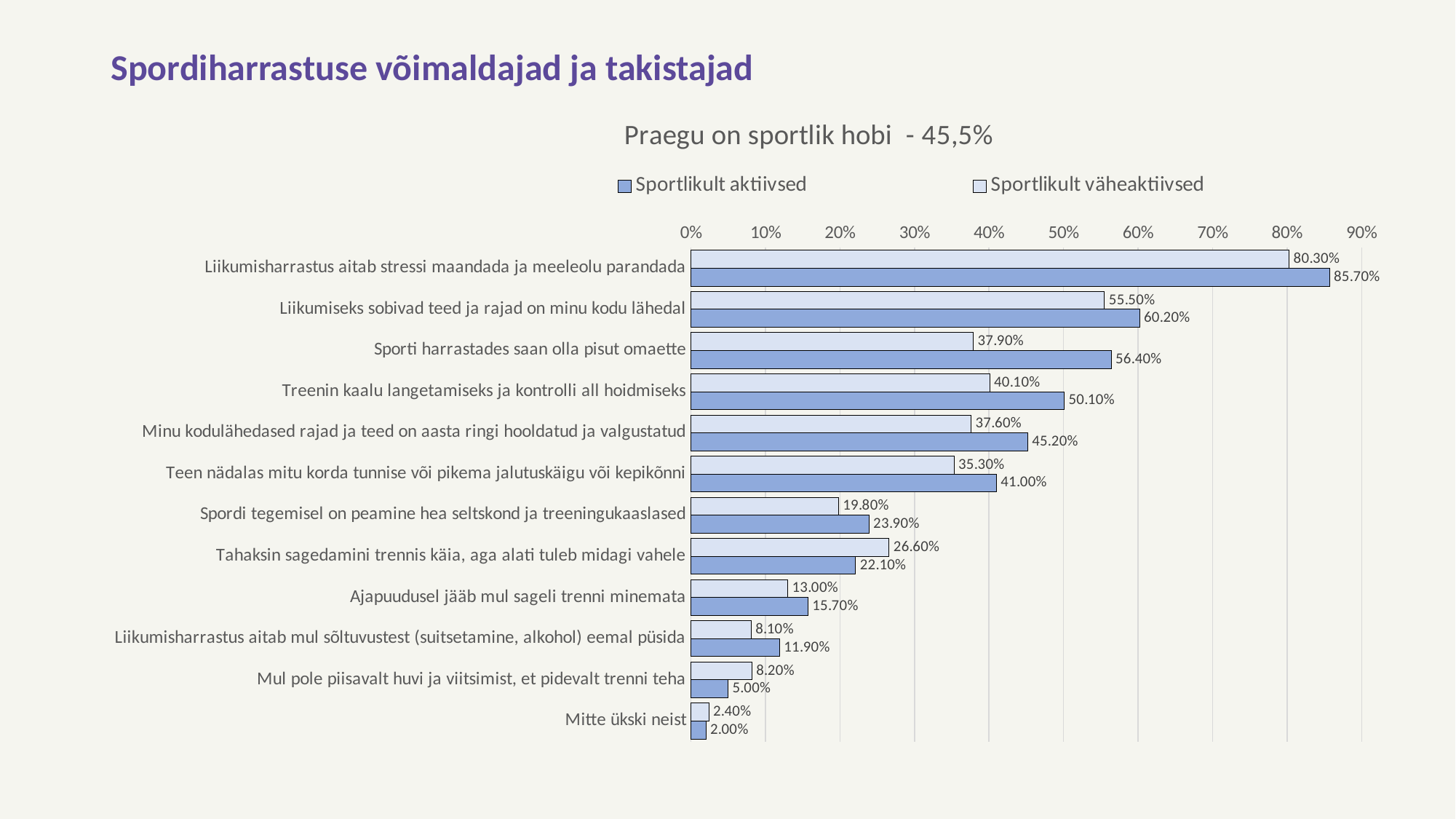
Which category has the highest value for "Sportlikult aktiivsed"? Liikumisharrastus aitab stressi maandada ja meeleolu parandada What is the value for "Sportlikult väheaktiivsed" for "Ajapuudusel jääb mul sageli trenni minemata"? 13.00% What is the title of the chart? Praegu on sportlik hobi - 45,5% For "Mul pole piisavalt huvi ja viitsimist, et pidevalt trenni teha", which series has the larger value? Sportlikult väheaktiivsed How many series does the legend list? 2 What is the value for "Sportlikult aktiivsed" for "Sporti harrastades saan olla pisut omaette"? 56.40% What kind of chart is shown on the slide? Bar chart Is the "Sportlikult aktiivsed" value for "Liikumiseks sobivad teed ja rajad on minu kodu lähedal" greater or less than 50%? greater How many categories are shown on the chart? 12 For "Tahaksin sagedamini trennis käia, aga alati tuleb midagi vahele", which series has the larger value? Sportlikult väheaktiivsed What is the difference between the "Sportlikult aktiivsed" and "Sportlikult väheaktiivsed" values for "Treenin kaalu langetamiseks ja kontrolli all hoidmiseks"? 10.00% Which category has the lowest value for "Sportlikult väheaktiivsed"? Mitte ükski neist